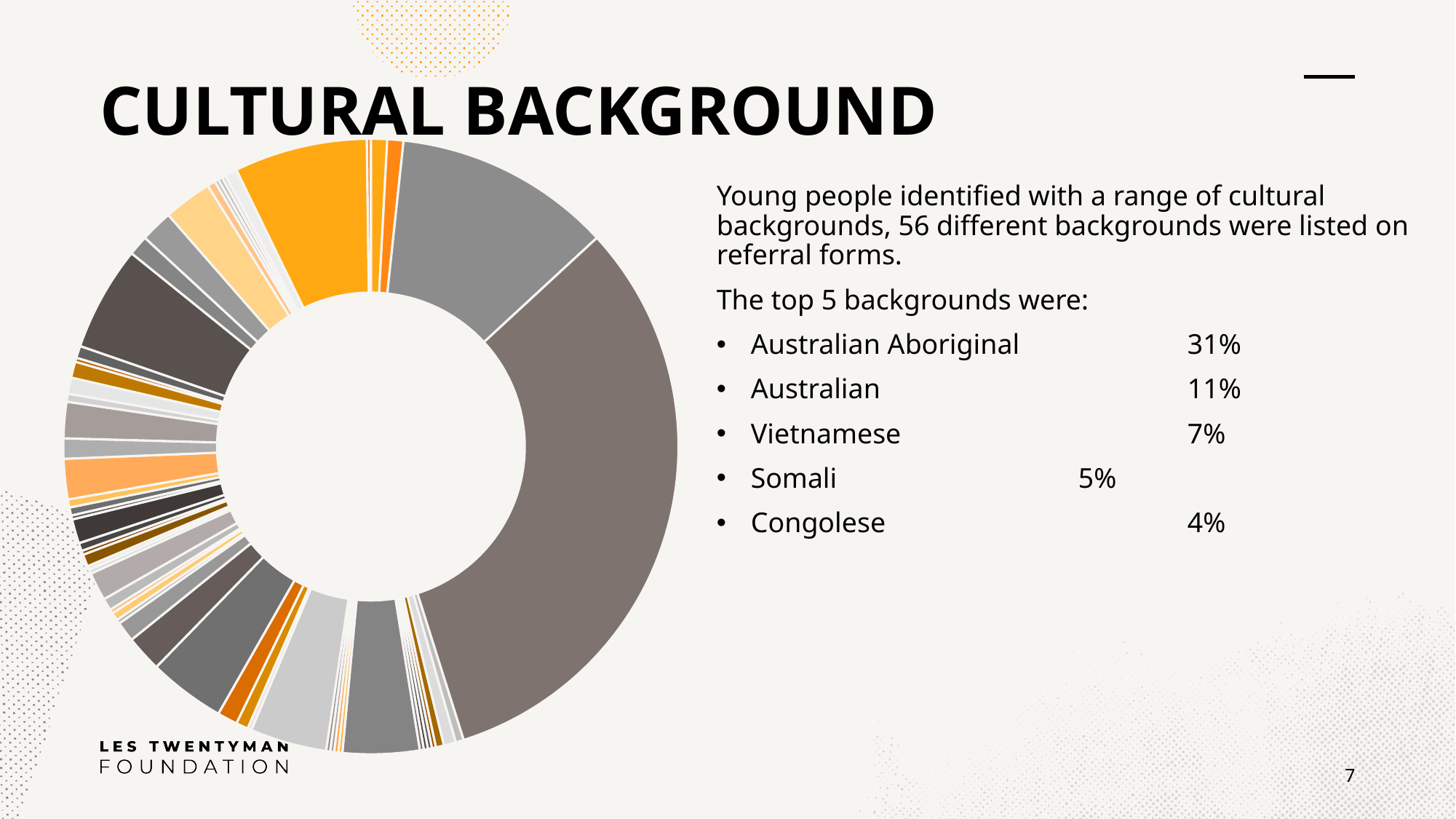
What share of young people identified as Somali? 5% What share of young people identified as Congolese? 4% According to the slide, how many different cultural backgrounds were listed on referral forms? 56 Which of the top 5 backgrounds has the smallest share? Congolese What share of young people identified as Australian? 11% What is the difference in share between Australian Aboriginal and Australian? 20% Which has a larger share, Vietnamese or Somali? Vietnamese What is the title of the slide containing the chart? CULTURAL BACKGROUND What share of young people identified as Vietnamese? 7% What share of young people identified as Australian Aboriginal? 31% What kind of chart is shown on the slide? Pie chart (donut) Which cultural background has the largest share? Australian Aboriginal